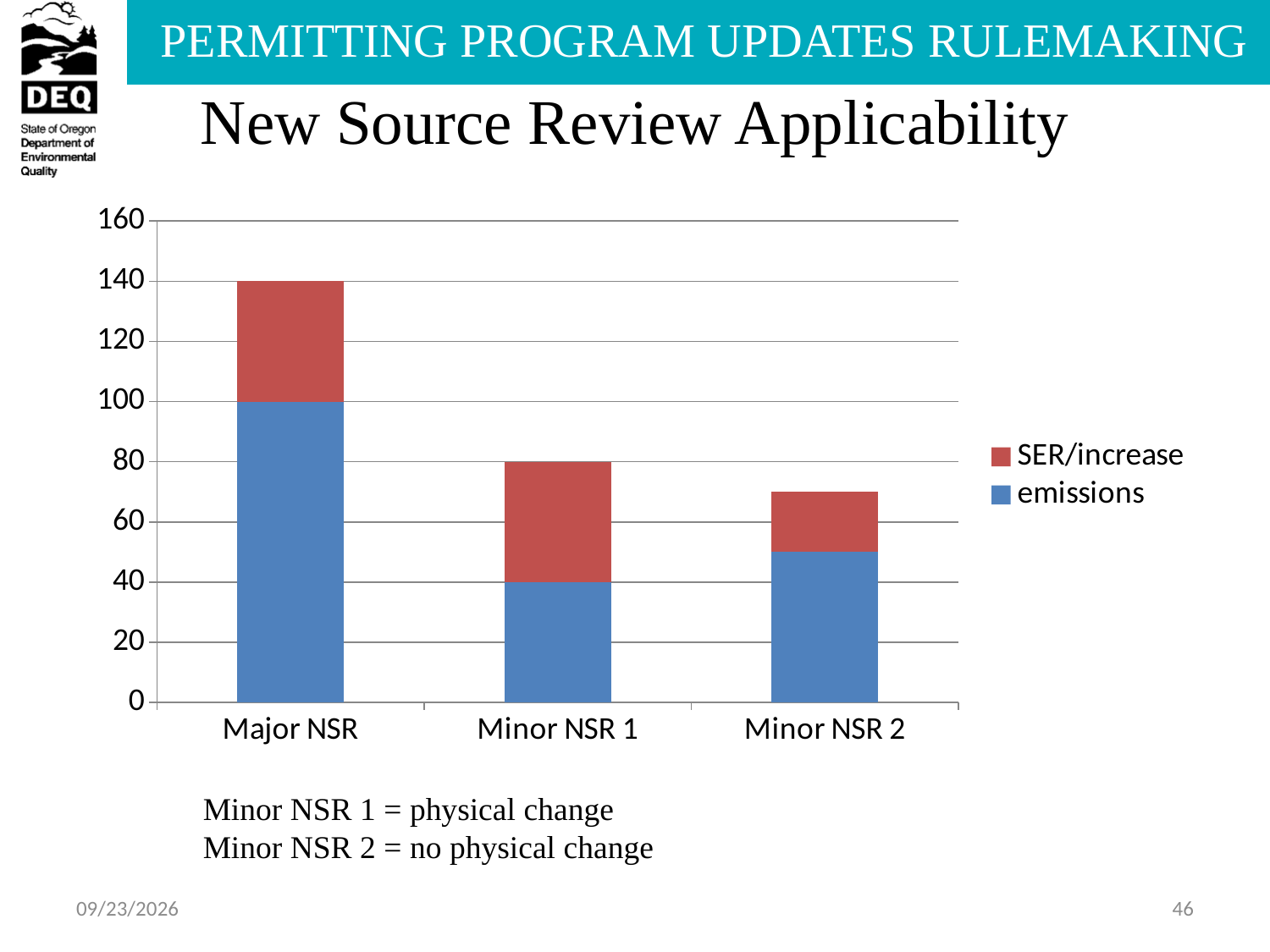
What is the emissions value for Major NSR? 100 Is the emissions value for Minor NSR 2 greater or less than 40? greater How many categories are shown on the x axis of the chart? 3 What is the total height of the stacked bar for Minor NSR 1? 80 How many series does the chart legend list? 2 What is the emissions value for Minor NSR 1? 40 What kind of chart is shown on the slide? Stacked bar chart What are the two series named in the chart legend? SER/increase and emissions What is the total height of the stacked bar for Major NSR? 140 Which category has the tallest stacked bar? Major NSR Which category has the shortest stacked bar? Minor NSR 2 Is the total stacked value for Minor NSR 2 greater or less than 80? less